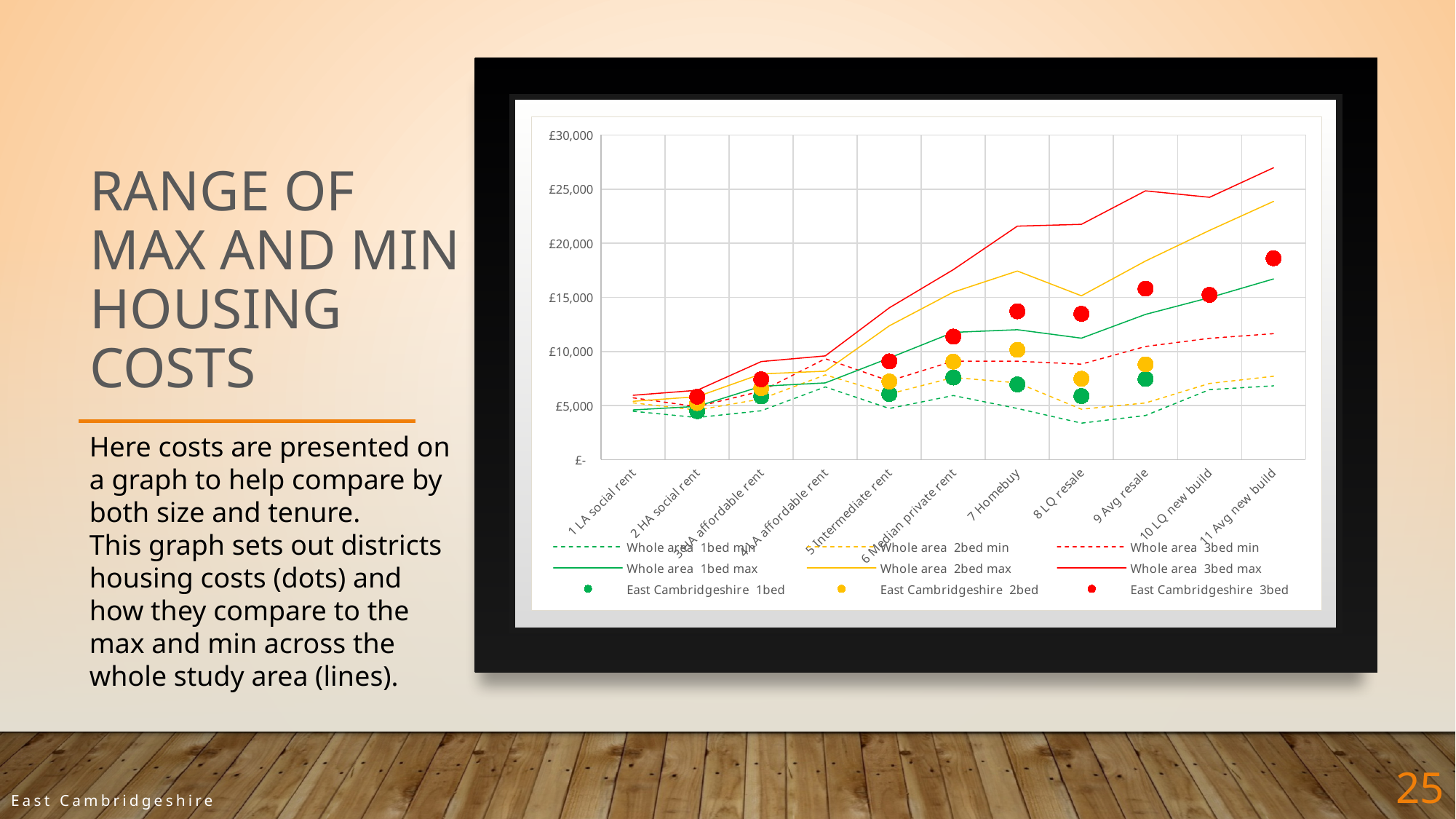
At which category does the Whole area 1bed min line reach its lowest value? 8 LQ resale What kind of chart is shown on the slide? line chart Is the value for Whole area 3bed max at 11 Avg new build greater or less than £25,000? greater Does the Whole area 3bed max line generally rise or fall from 1 LA social rent to 11 Avg new build? rise What colour are the East Cambridgeshire 3bed dots in the chart? red How many categories are shown on the x axis of the chart? 11 Is the value for Whole area 1bed min at 8 LQ resale greater or less than £5,000? less Is the value for East Cambridgeshire 3bed at 11 Avg new build greater or less than £15,000? greater How many series does the chart's legend list? 9 At which category does the Whole area 3bed max line reach its highest value? 11 Avg new build